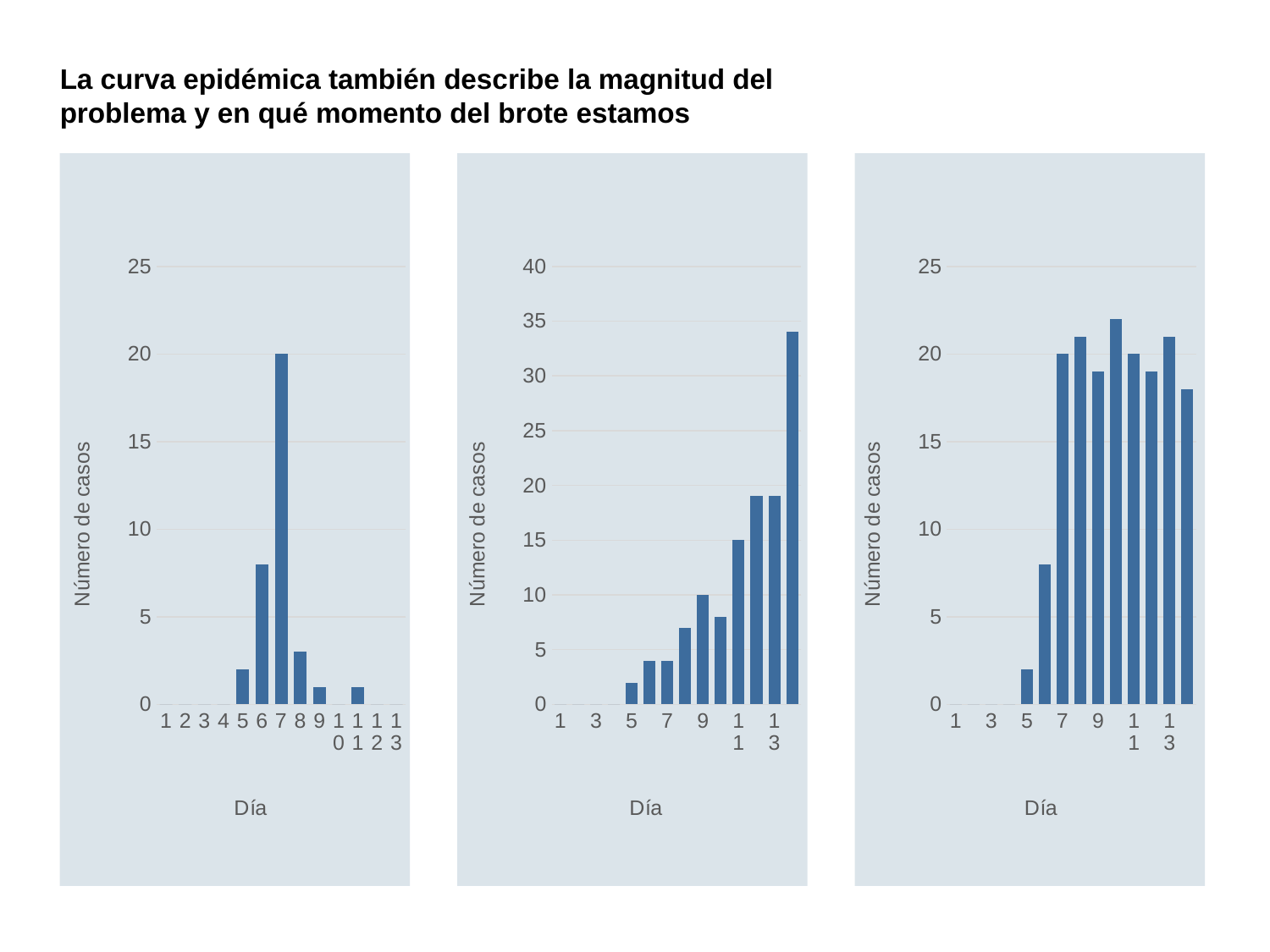
In the middle chart, is the value for the last day greater or less than 30? greater What is the x-axis label of the middle chart? Día What kind of chart is the left chart on the slide? bar chart In the right chart, is the value for day 10 greater or less than 20? greater In the left chart, what is the number of cases on day 7? 20 In the middle chart, what is the number of cases on day 9? 10 In the right chart, which is larger, the value for day 6 or the value for day 7? day 7 In the middle chart, which day has the highest number of cases? 14 In the left chart, which day has the highest number of cases? 7 In the left chart, is the value for day 6 greater or less than 5? greater What is the y-axis label of the right chart? Número de casos In the middle chart, do the values generally rise or fall from day 5 to day 14? rise